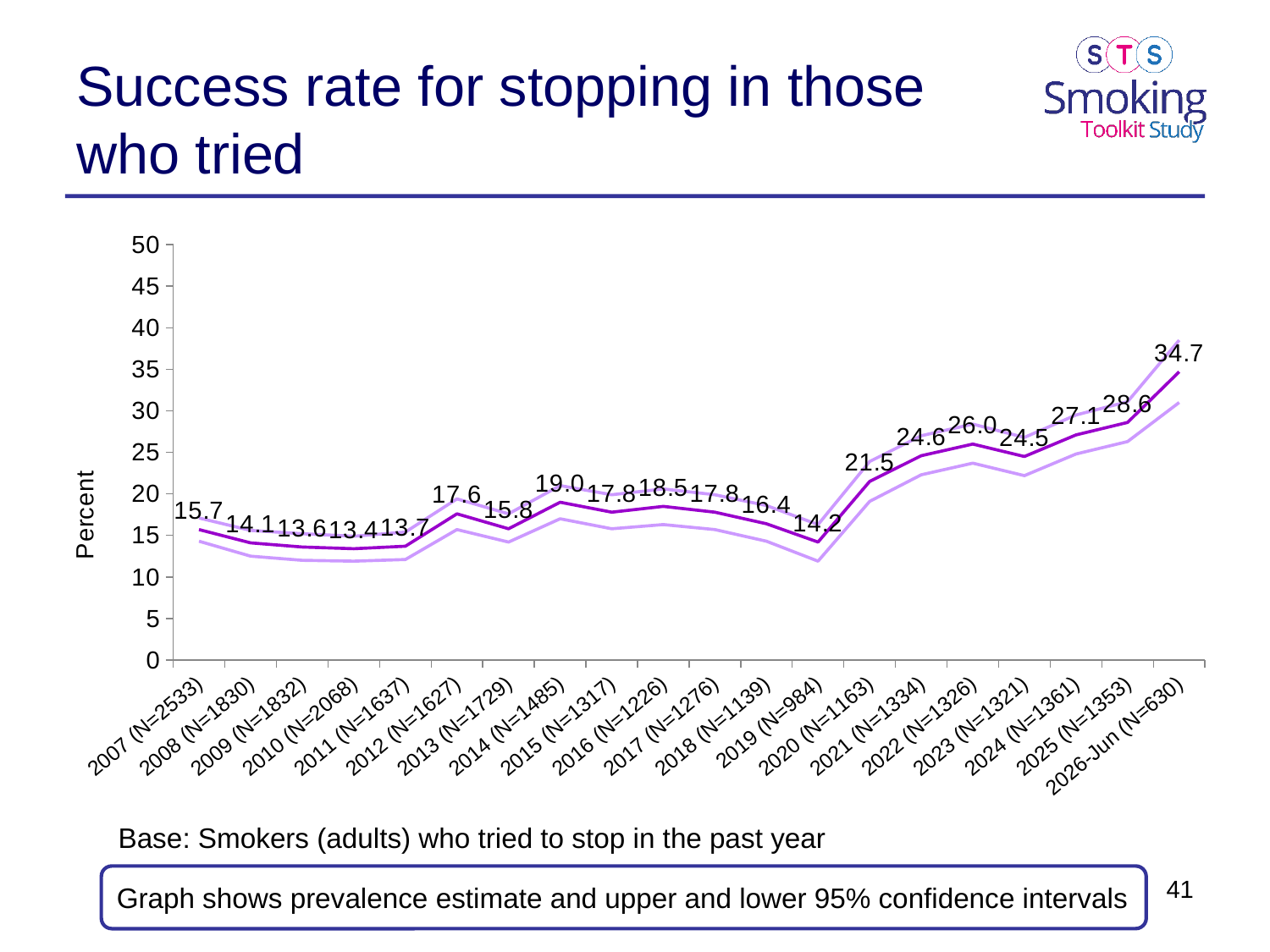
What is the success rate for 2026-Jun (N=630)? 34.7 Which year has the lowest success rate? 2010 (N=2068) What is the difference between the success rate in 2026-Jun (N=630) and in 2025 (N=1353)? 6.1 How many time points are plotted on the chart? 20 What is the success rate for 2014 (N=1485)? 19.0 What kind of chart is shown on the slide? Line chart Does the success rate rise or fall from 2019 (N=984) to 2026-Jun (N=630)? Rise Which is larger, the success rate in 2019 (N=984) or in 2020 (N=1163)? 2020 (N=1163) Is the upper confidence interval value for 2026-Jun (N=630) greater or less than 35? greater What is the success rate for 2007 (N=2533)? 15.7 What is the success rate for 2022 (N=1326)? 26.0 Which year has the highest success rate? 2026-Jun (N=630)